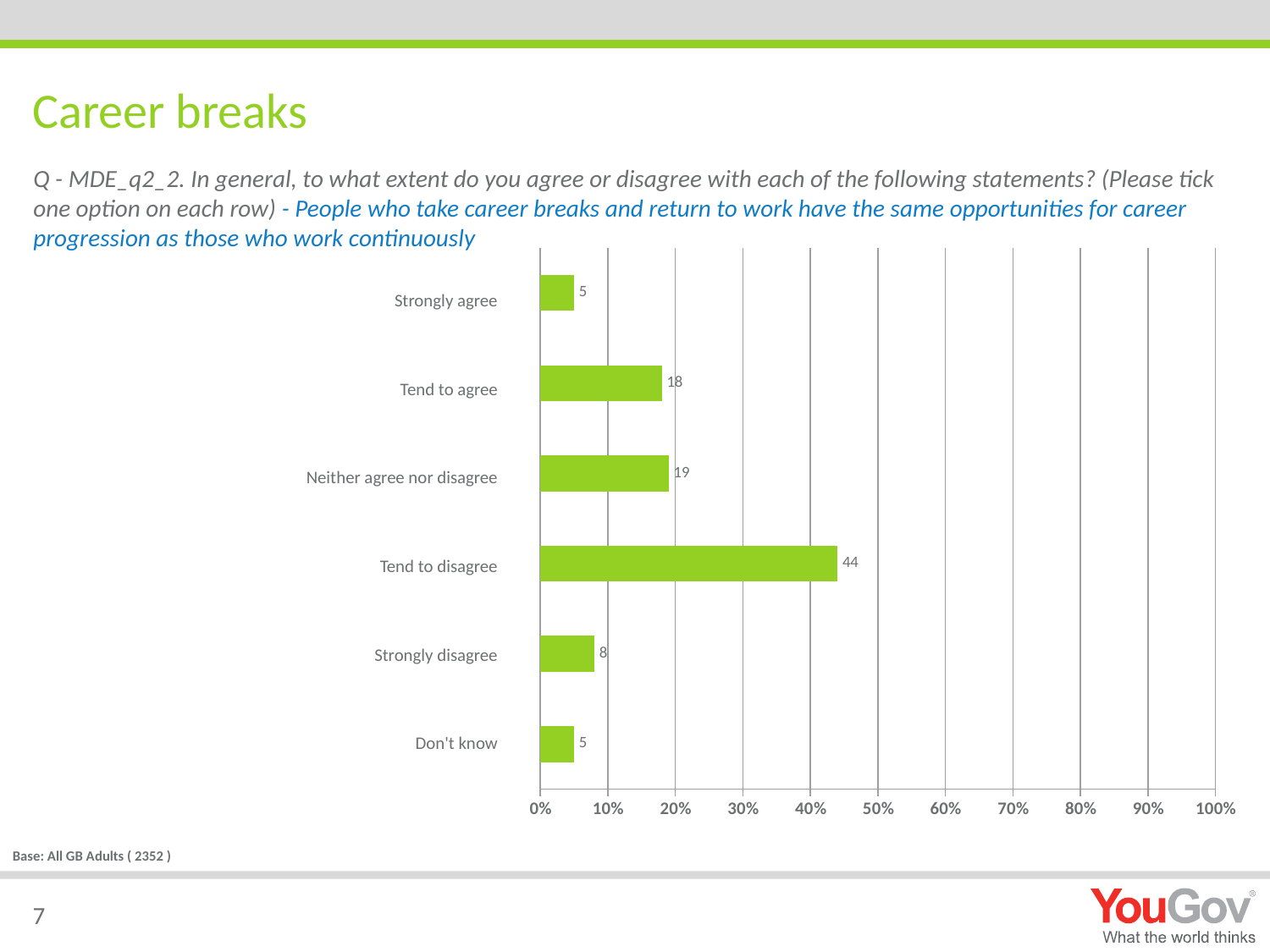
What is the value for Neither agree nor disagree? 19 What is the value for Strongly disagree? 8 What is the value for Tend to agree? 18 Is the value for Tend to disagree greater or less than 40%? greater What kind of chart is shown on the slide? bar chart What is the difference between the values for Neither agree nor disagree and Strongly disagree? 11 Which is larger, the value for Strongly disagree or the value for Tend to agree? Tend to agree What is the title of the slide? Career breaks What is the value for Tend to disagree? 44 What is the difference between the values for Tend to disagree and Tend to agree? 26 How many categories are shown in the chart? 6 Which category has the highest value? Tend to disagree